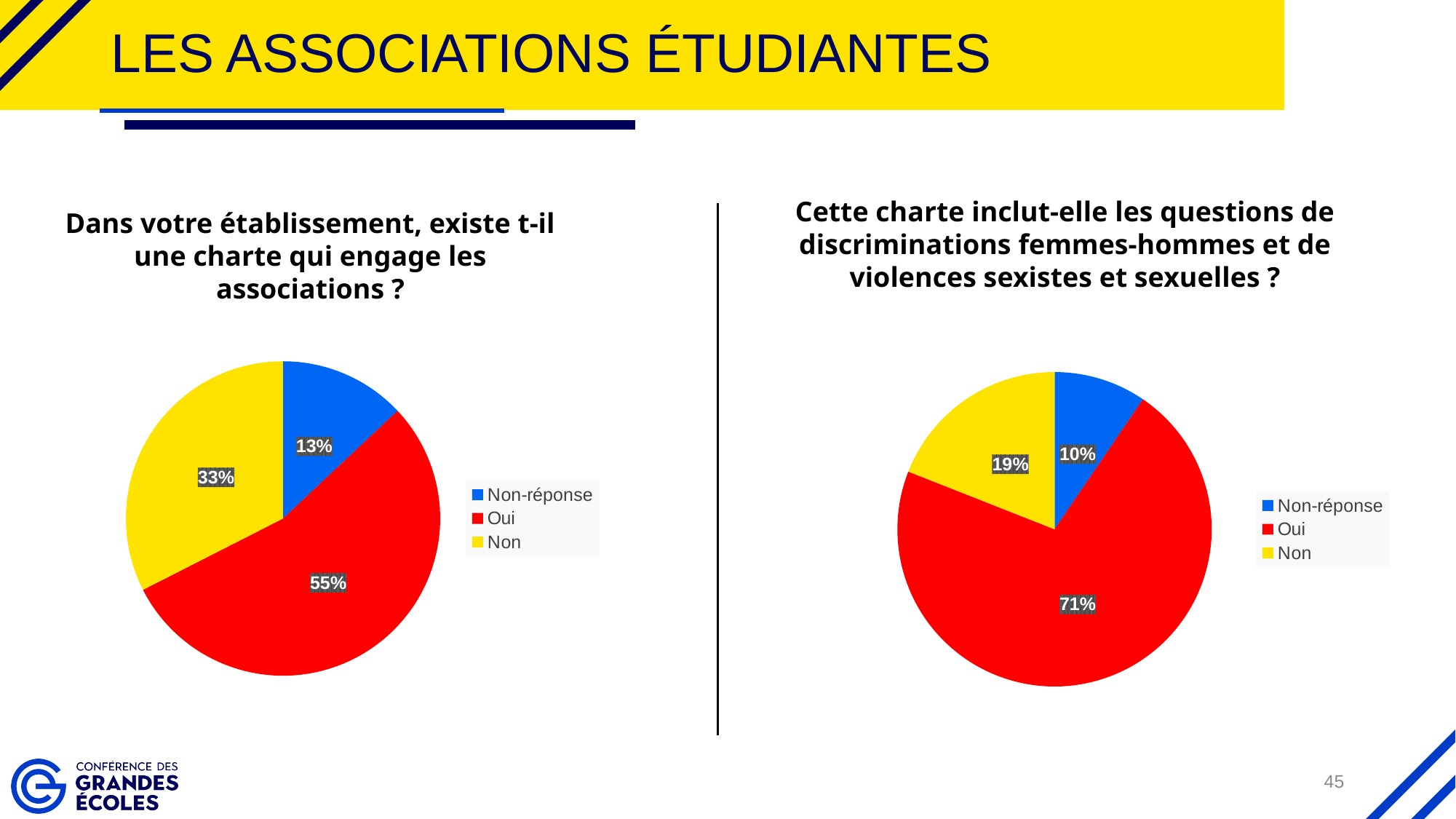
In the left pie chart (charte qui engage les associations), what share is labelled for Non? 33% How many categories does the legend of the right pie chart list? 3 In the right pie chart (discriminations femmes-hommes et violences sexistes et sexuelles), what share is labelled for Non? 19% In the right pie chart (discriminations femmes-hommes et violences sexistes et sexuelles), what share is labelled for Oui? 71% In the left pie chart (charte qui engage les associations), what share is labelled for Oui? 55% In the left pie chart, which category has the largest slice? Oui In the left pie chart (charte qui engage les associations), what share is labelled for Non-réponse? 13% In the right pie chart, which category has the smallest slice? Non-réponse What type of chart is used on the left side of the slide? Pie chart In the right pie chart, which is larger: Non or Non-réponse? Non In the left pie chart, what is the difference in percentage points between Oui and Non? 22 In the right pie chart (discriminations femmes-hommes et violences sexistes et sexuelles), what share is labelled for Non-réponse? 10%